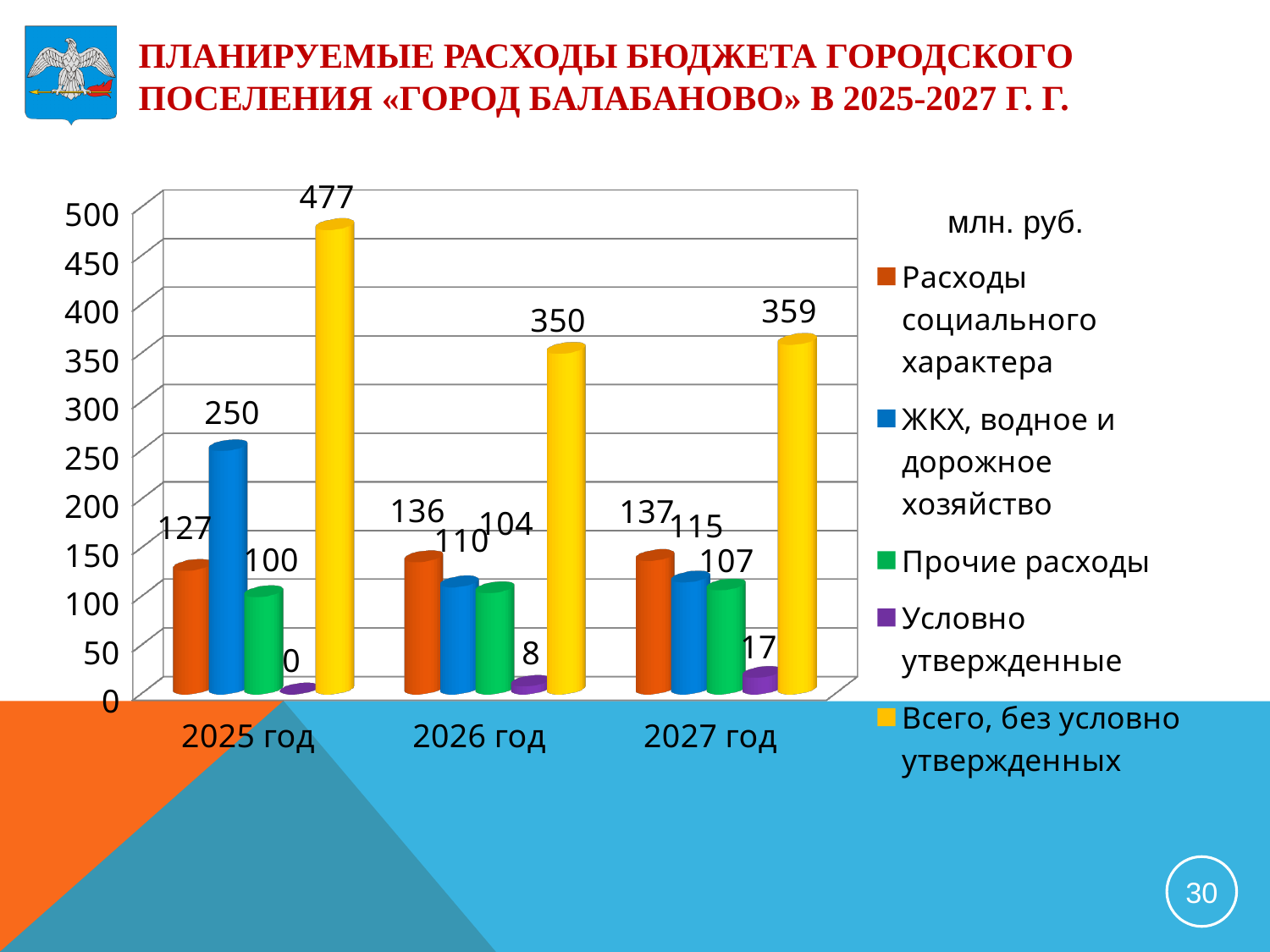
Which is larger: «Прочие расходы» in 2026 год or in 2027 год? 2027 год What is the value for «Всего, без условно утвержденных» in 2026 год? 350 What is the value for «Расходы социального характера» in 2025 год? 127 What kind of chart is shown on the slide? Bar chart What unit is indicated above the legend? млн. руб. In which year is «Условно утвержденные» the lowest? 2025 год In which year is «Всего, без условно утвержденных» the highest? 2025 год What is the value for «ЖКХ, водное и дорожное хозяйство» in 2025 год? 250 How many years are shown on the x axis? 3 What is the difference between «Всего, без условно утвержденных» in 2025 год and 2026 год? 127 How many series does the legend list? 5 What is the value for «Условно утвержденные» in 2027 год? 17